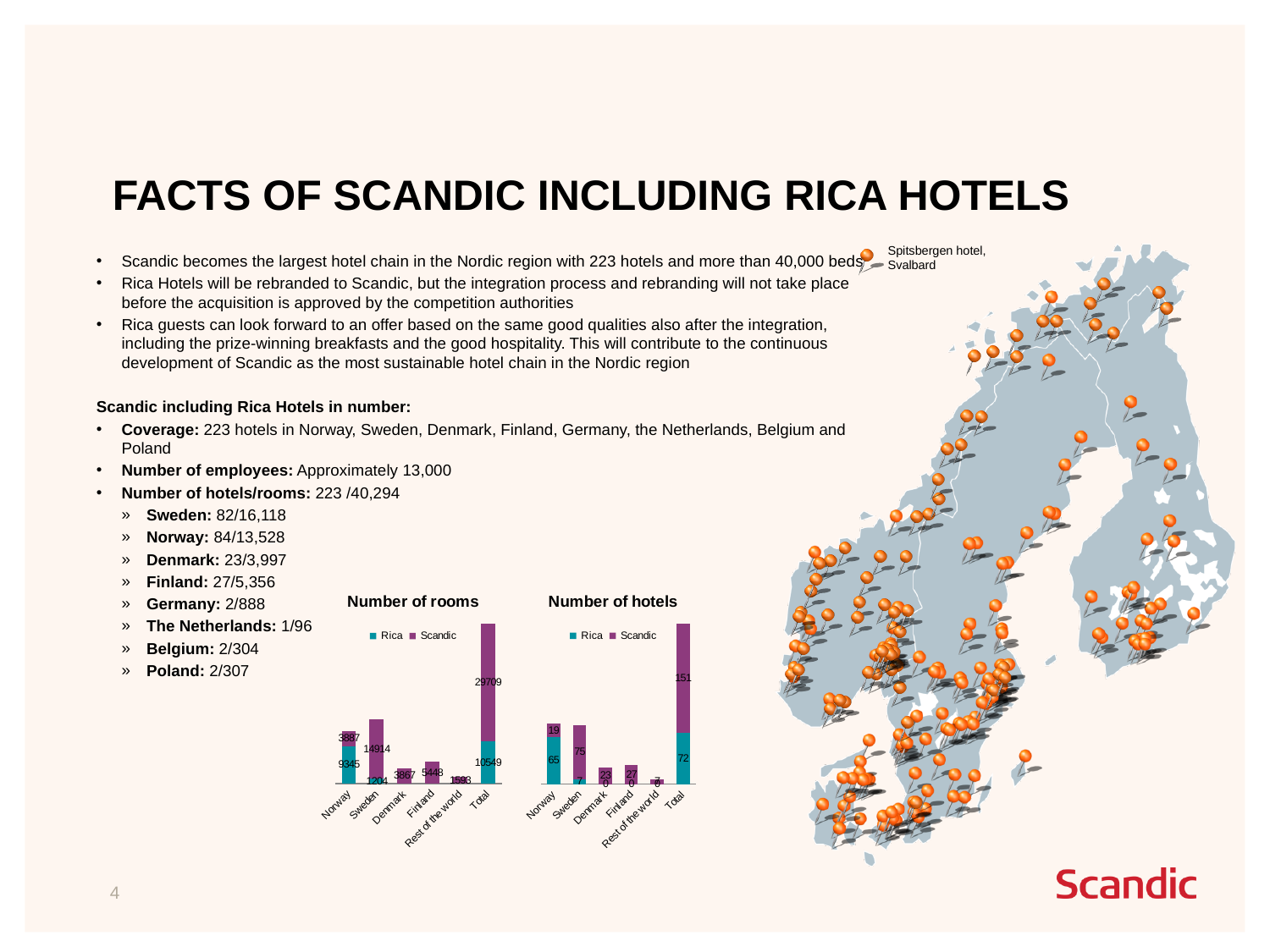
In the 'Number of rooms' chart, what is the Scandic value for Total? 29709 In the 'Number of hotels' chart, what is the total height of the stacked bar for Norway (Rica plus Scandic)? 84 How many series does the legend of the 'Number of rooms' chart list? 2 In the 'Number of hotels' chart, how many Rica hotels are in Norway? 65 What kind of chart is the 'Number of hotels' chart? Stacked bar chart In the 'Number of hotels' chart, what is the Scandic value for Total? 151 How many categories are shown on the x axis of the 'Number of hotels' chart? 6 In the 'Number of hotels' chart, which has more Rica hotels, Norway or Sweden? Norway In the 'Number of hotels' chart, what is the Rica value for Total? 72 In the 'Number of rooms' chart, what is the Rica value for Total? 10549 In the 'Number of rooms' chart, what is the Scandic value for Sweden? 14914 In the 'Number of hotels' chart, how many Scandic hotels are in Sweden? 75